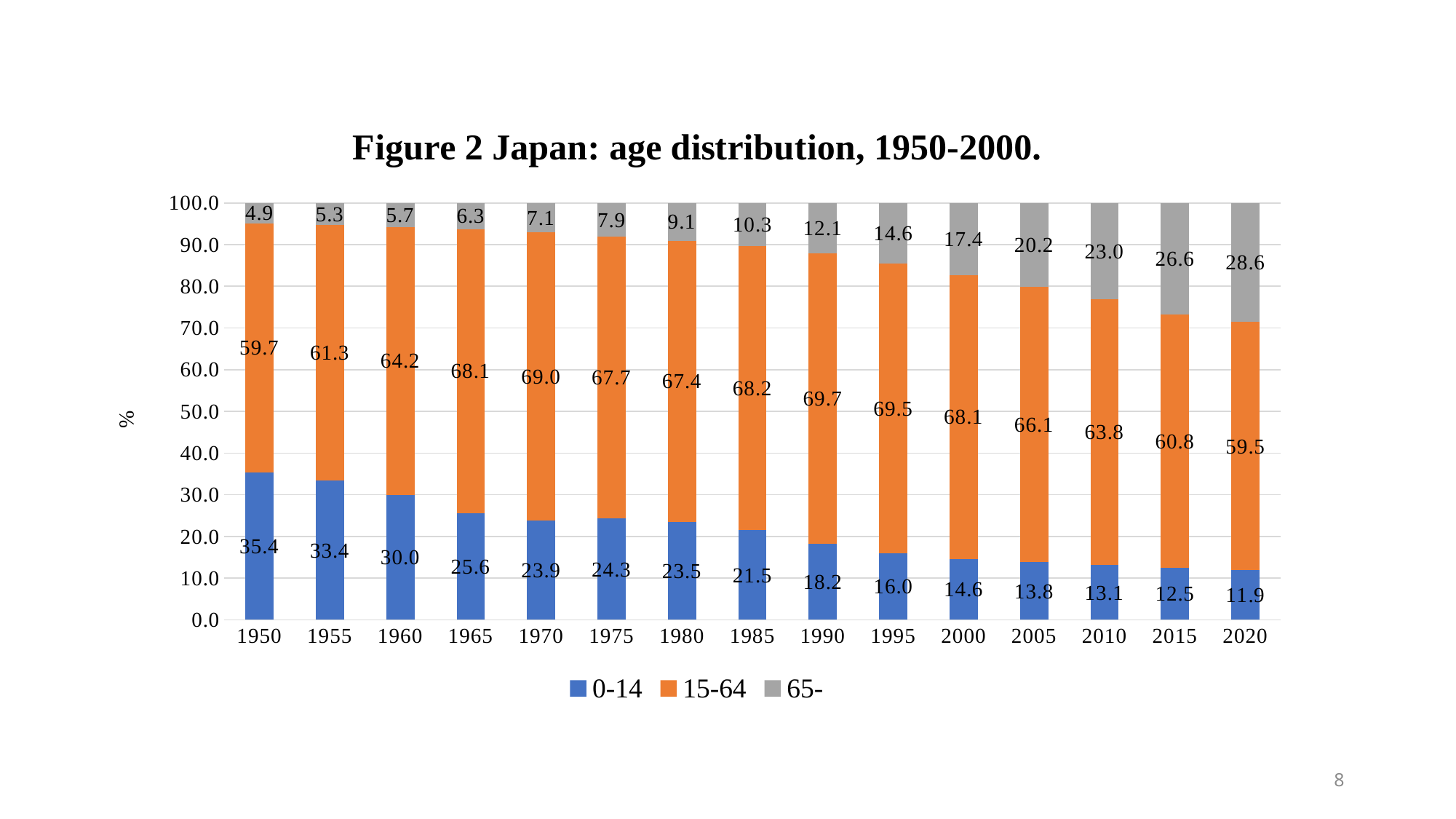
In which year is the 65- age group share highest? 2020 What is the value for the 65- age group in 2020? 28.6 Which is larger: the 0-14 value in 1975 or in 1970? 1975 What is the difference between the 65- value in 2020 and in 1950? 23.7 What is the value for the 0-14 age group in 1950? 35.4 What is the value for the 15-64 age group in 1990? 69.7 How many series does the legend list? 3 How many years are shown on the x axis? 15 What is the total of the stacked bar for 2020? 100.0 Does the 0-14 share rise or fall from 1950 to 2020? Fall What type of chart is shown on the slide? Stacked bar chart In which year is the 0-14 age group share lowest? 2020